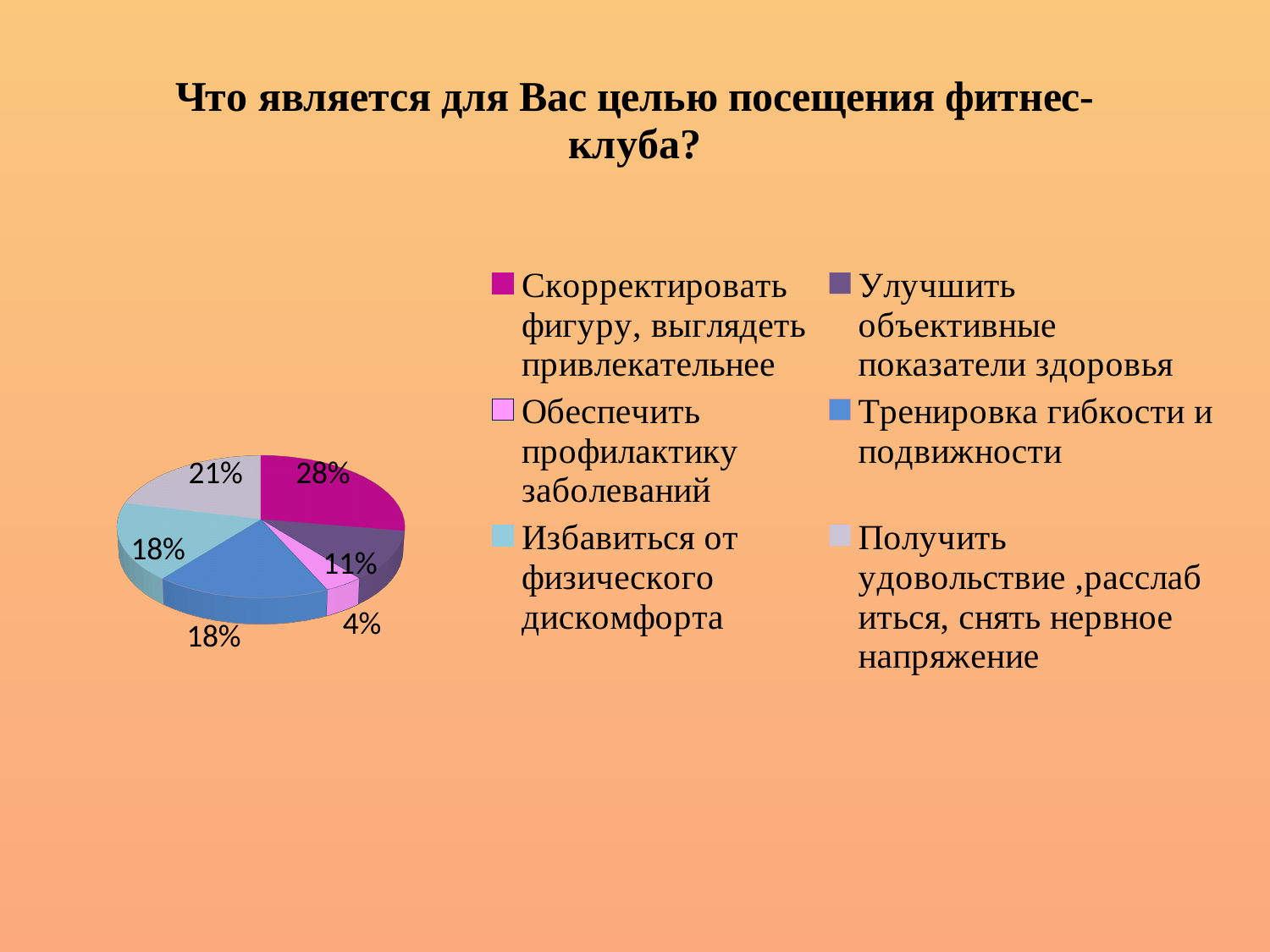
What share of the pie is labelled for "Тренировка гибкости и подвижности"? 18% Which category has the largest slice of the pie? Скорректировать фигуру, выглядеть привлекательнее What share of the pie is labelled for "Скорректировать фигуру, выглядеть привлекательнее"? 28% What share of the pie is labelled for "Обеспечить профилактику заболеваний"? 4% What kind of chart is shown on the slide? pie chart Which slice is larger: "Улучшить объективные показатели здоровья" or "Избавиться от физического дискомфорта"? Избавиться от физического дискомфорта What share of the pie is labelled for "Получить удовольствие, расслабиться, снять нервное напряжение"? 21% What is the difference in percentage points between the largest slice (28%) and the slice for "Получить удовольствие, расслабиться, снять нервное напряжение" (21%)? 7 Which category has the smallest slice of the pie? Обеспечить профилактику заболеваний What is the title of the chart on the slide? Что является для Вас целью посещения фитнес-клуба? How many slices does the pie chart have? 6 What share of the pie is labelled for "Улучшить объективные показатели здоровья"? 11%